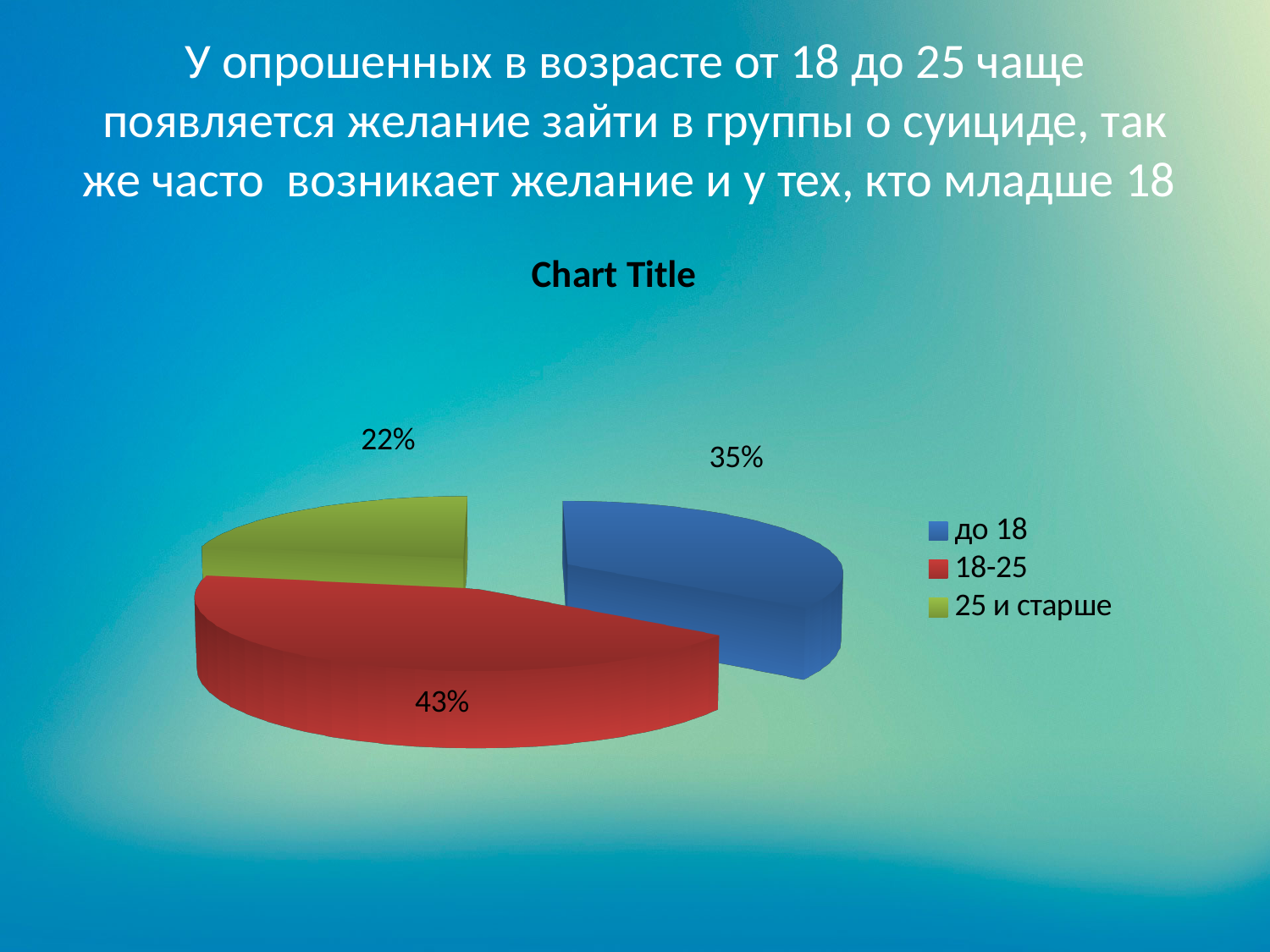
How many entries does the legend list? 3 What is the difference in percentage points between the "18-25" slice and the "до 18" slice? 8% What is the difference in percentage points between the "до 18" slice and the "25 и старше" slice? 13% Which age group has the smallest slice of the pie? 25 и старше What share of the pie does the "18-25" slice have? 43% Which is larger, the "до 18" slice or the "25 и старше" slice? до 18 How many slices does the pie chart have? 3 What kind of chart is shown on the slide? pie chart Which age group has the largest slice of the pie? 18-25 What share of the pie does the "25 и старше" slice have? 22% What colour is the "18-25" slice in the pie chart? red What share of the pie does the "до 18" slice have? 35%